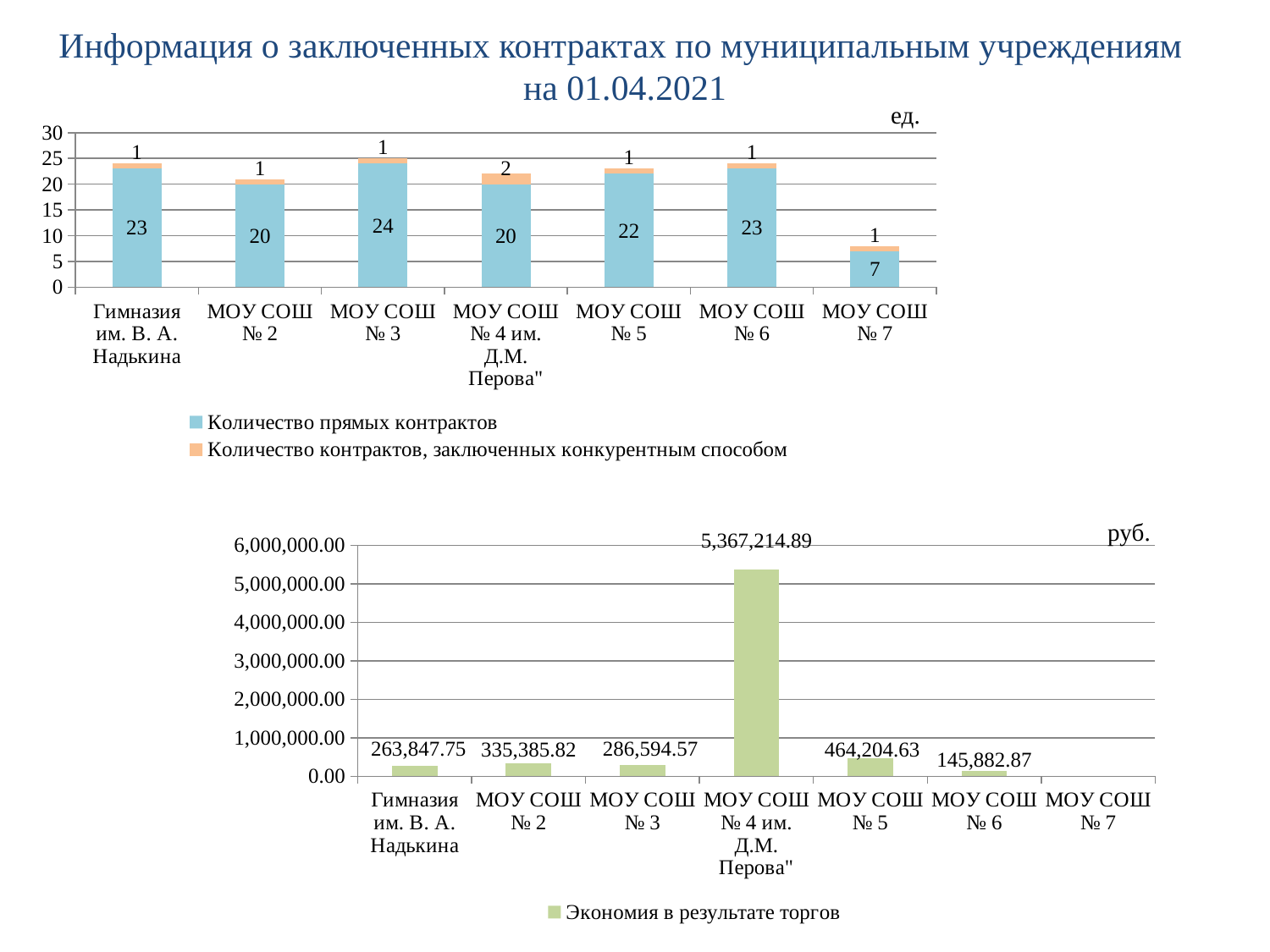
In the top chart, how many direct contracts (Количество прямых контрактов) does МОУ СОШ № 3 have? 24 In the top chart, how many contracts concluded by competitive method does МОУ СОШ № 4 им. Д.М. Перова" have? 2 In the top chart, what is the total number of contracts (both series) for МОУ СОШ № 7? 8 In the bottom chart, which is larger: the savings for МОУ СОШ № 2 or for МОУ СОШ № 3? МОУ СОШ № 2 In the top chart, which institution has the lowest number of direct contracts? МОУ СОШ № 7 In the bottom chart, which institution has the highest savings from bidding? МОУ СОШ № 4 им. Д.М. Перова" In the bottom chart, what is the savings value (Экономия в результате торгов) for МОУ СОШ № 5? 464,204.63 How many series does the legend of the top chart list? 2 What type of chart is the bottom chart? bar chart In the top chart, which institution has the highest number of direct contracts? МОУ СОШ № 3 In the bottom chart, is the savings value for МОУ СОШ № 4 им. Д.М. Перова" greater or less than 5,000,000.00? greater In the top chart, what is the difference in direct contracts between МОУ СОШ № 3 and МОУ СОШ № 2? 4